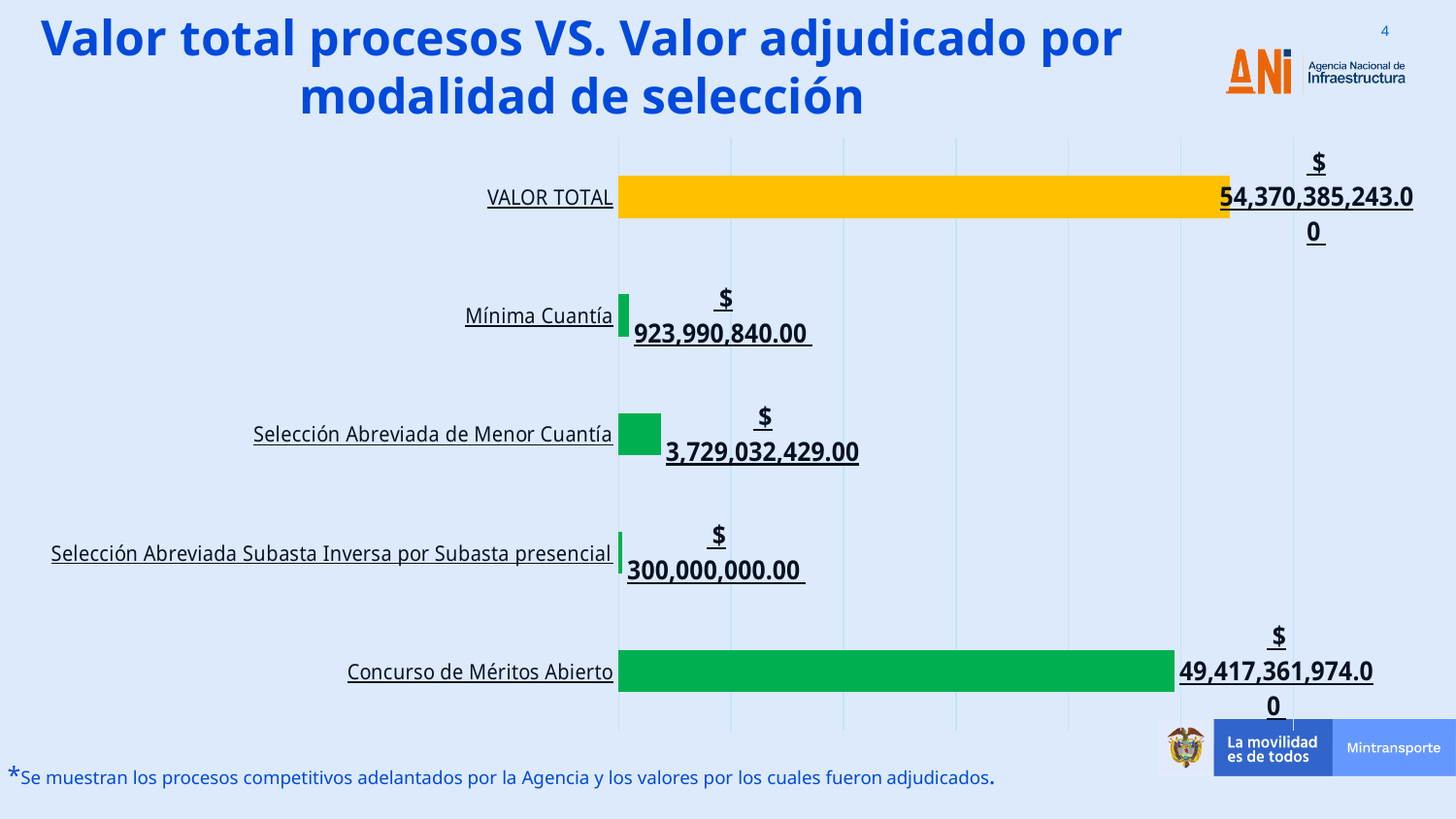
What is the value shown for Mínima Cuantía? $ 923,990,840.00 What is the value shown for Concurso de Méritos Abierto? $ 49,417,361,974.00 Which category has the lowest value in the chart? Selección Abreviada Subasta Inversa por Subasta presencial What is the value shown for VALOR TOTAL? $ 54,370,385,243.00 Which is larger: the value for Concurso de Méritos Abierto or the value for Selección Abreviada de Menor Cuantía? Concurso de Méritos Abierto Which category has the highest value in the chart? VALOR TOTAL What type of chart is shown on the slide? Bar chart What is the difference between the value for VALOR TOTAL and the value for Concurso de Méritos Abierto? $ 4,953,023,269.00 How many categories are plotted in the chart? 5 What is the value shown for Selección Abreviada de Menor Cuantía? $ 3,729,032,429.00 What is the value shown for Selección Abreviada Subasta Inversa por Subasta presencial? $ 300,000,000.00 What colour is the bar for VALOR TOTAL? Yellow